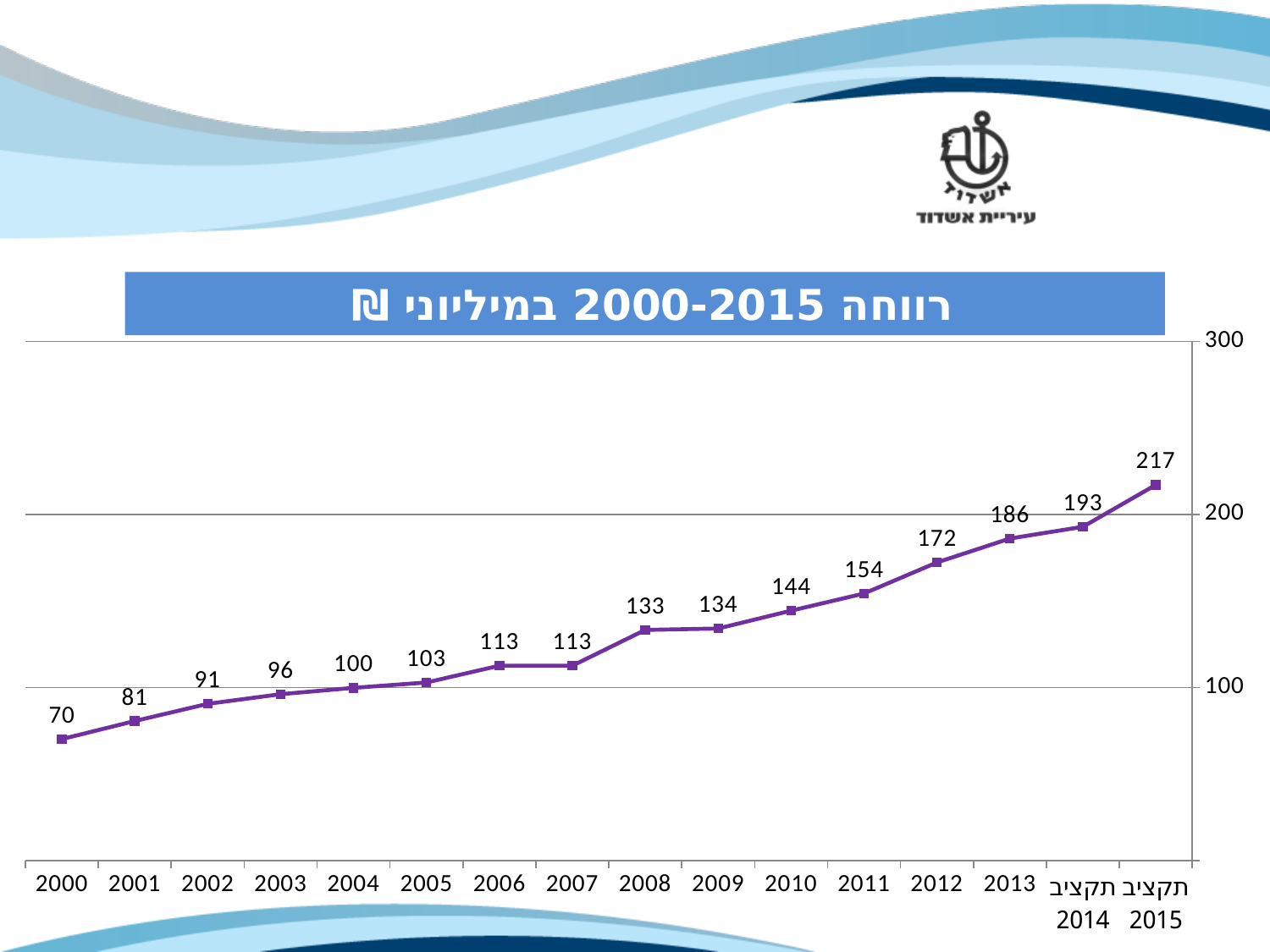
Which year has the highest value? תקציב 2015 Do the values generally rise or fall from 2000 to תקציב 2015? rise What kind of chart is shown on the slide? line chart What is the difference between the values for 2013 and 2012? 14 Which year has the lowest value? 2000 How many data points are plotted on the chart? 16 Which is larger, the value for 2008 or the value for 2010? 2010 What is the value for 2000? 70 Is the value for 2011 greater or less than 200? less What is the difference between the values for תקציב 2015 and 2000? 147 What is the value for תקציב 2015? 217 What is the value for 2012? 172